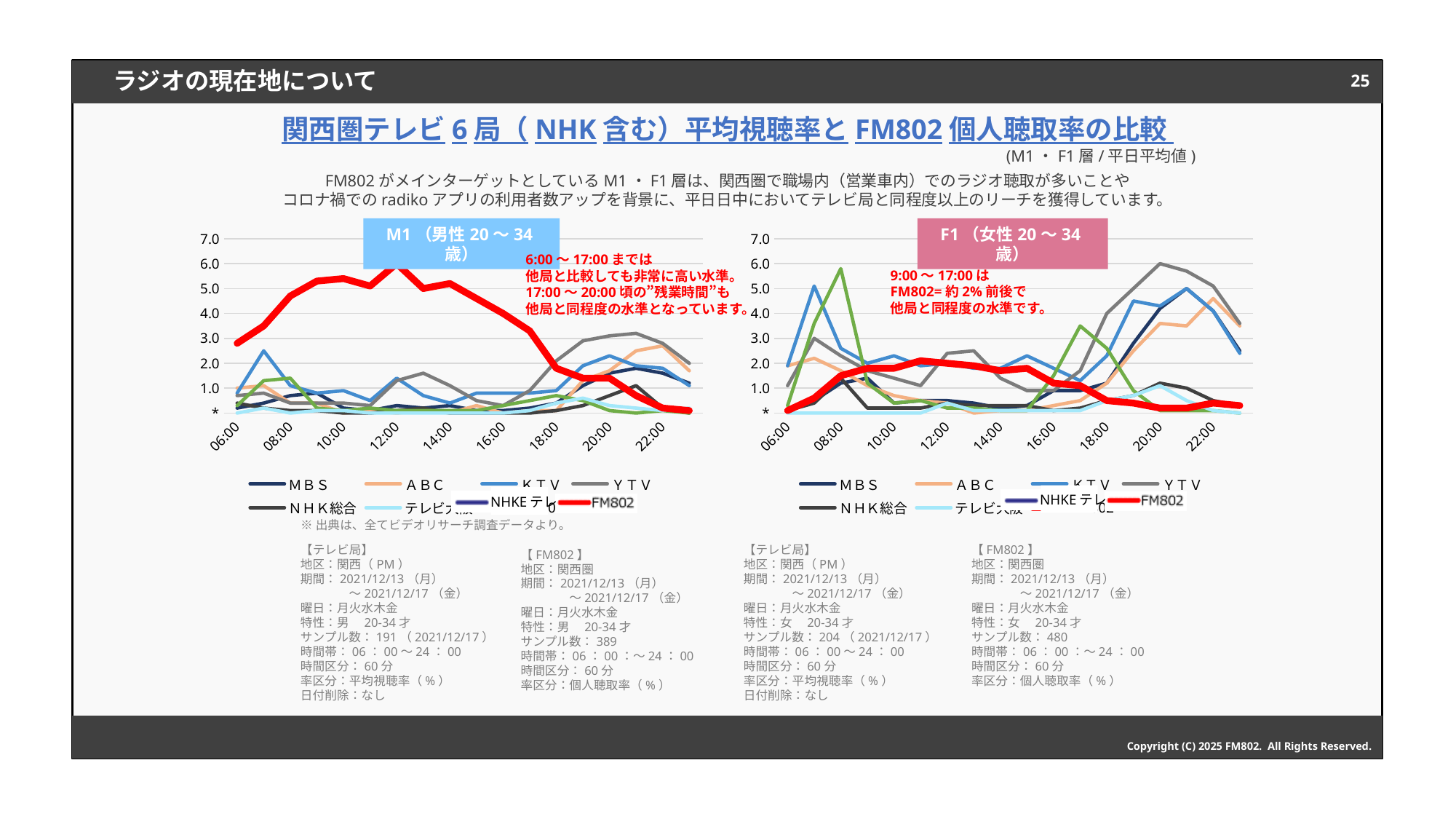
In the M1（男性20～34歳）chart, is the FM802 value at 06:00 greater or less than 2.0? greater How many time labels are shown on the x axis of the M1（男性20～34歳）chart? 9 In the M1（男性20～34歳）chart, which is larger at 10:00, FM802 or MBS? FM802 In the F1（女性20～34歳）chart, is the FM802 value at 12:00 greater or less than 3.0? less How many series does the legend of the F1（女性20～34歳）chart list? 8 In the F1（女性20～34歳）chart, is the YTV value at 20:00 greater or less than 5.0? greater In the M1（男性20～34歳）chart, which series has the highest value at 12:00? FM802 What is the highest tick value shown on the y axis of the F1（女性20～34歳）chart? 7.0 What colour is the FM802 line in the M1（男性20～34歳）chart? red In the M1（男性20～34歳）chart, does the FM802 line rise or fall from 12:00 to 22:00? fall What kind of chart is the M1（男性20～34歳）chart on the left? line chart